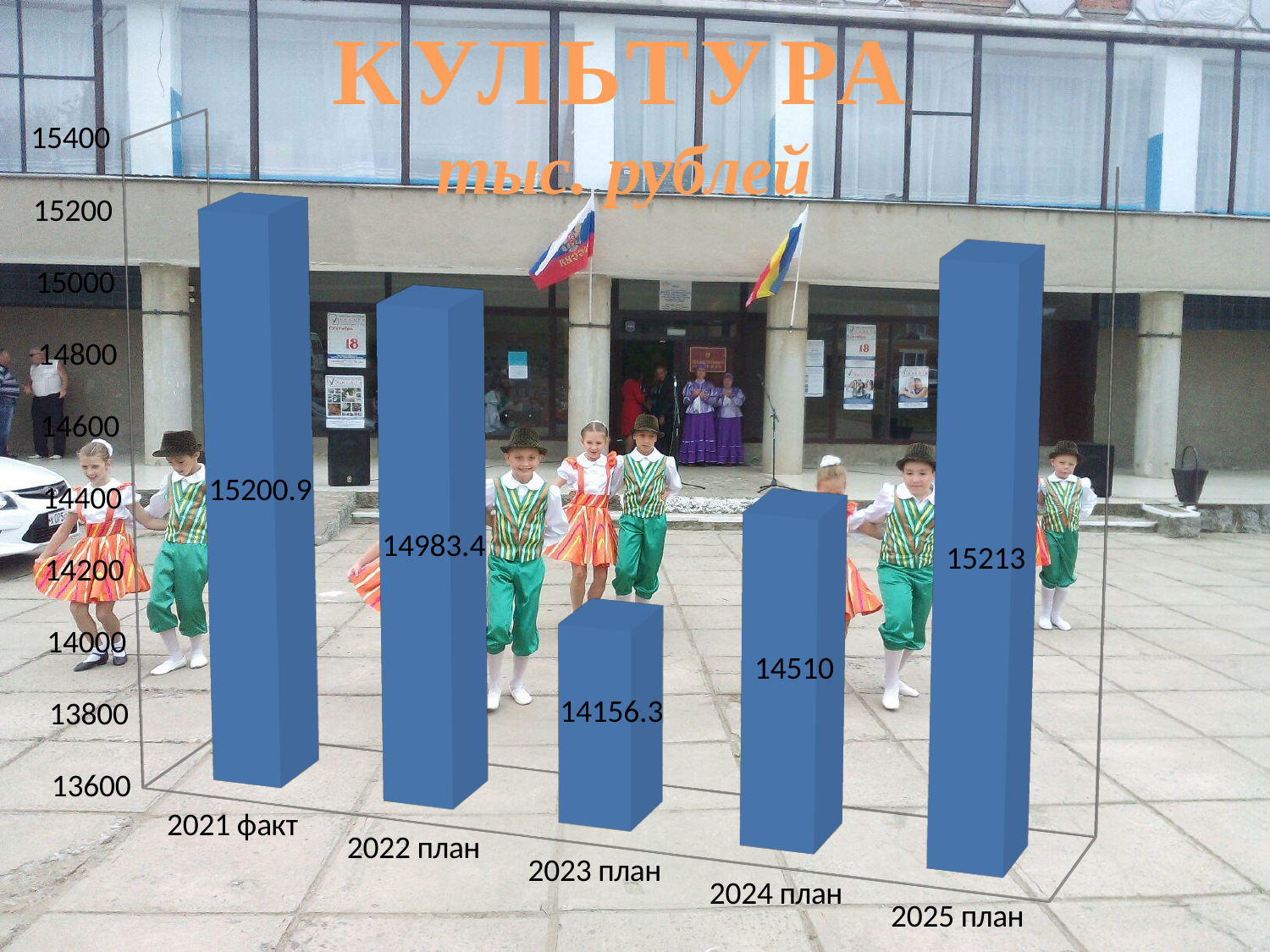
What is the difference between the values for 2025 план and 2024 план? 703 Do the values rise or fall from 2023 план to 2025 план? rise Which is larger, the value for 2022 план or the value for 2024 план? 2022 план What is the value for 2023 план? 14156.3 How many categories are shown in the chart? 5 What is the value for 2021 факт? 15200.9 Which category has the highest value? 2025 план What is the value for 2024 план? 14510 What is the difference between the values for 2021 факт and 2022 план? 217.5 What is the value for 2025 план? 15213 Which category has the lowest value? 2023 план What kind of chart is shown on the slide? bar chart